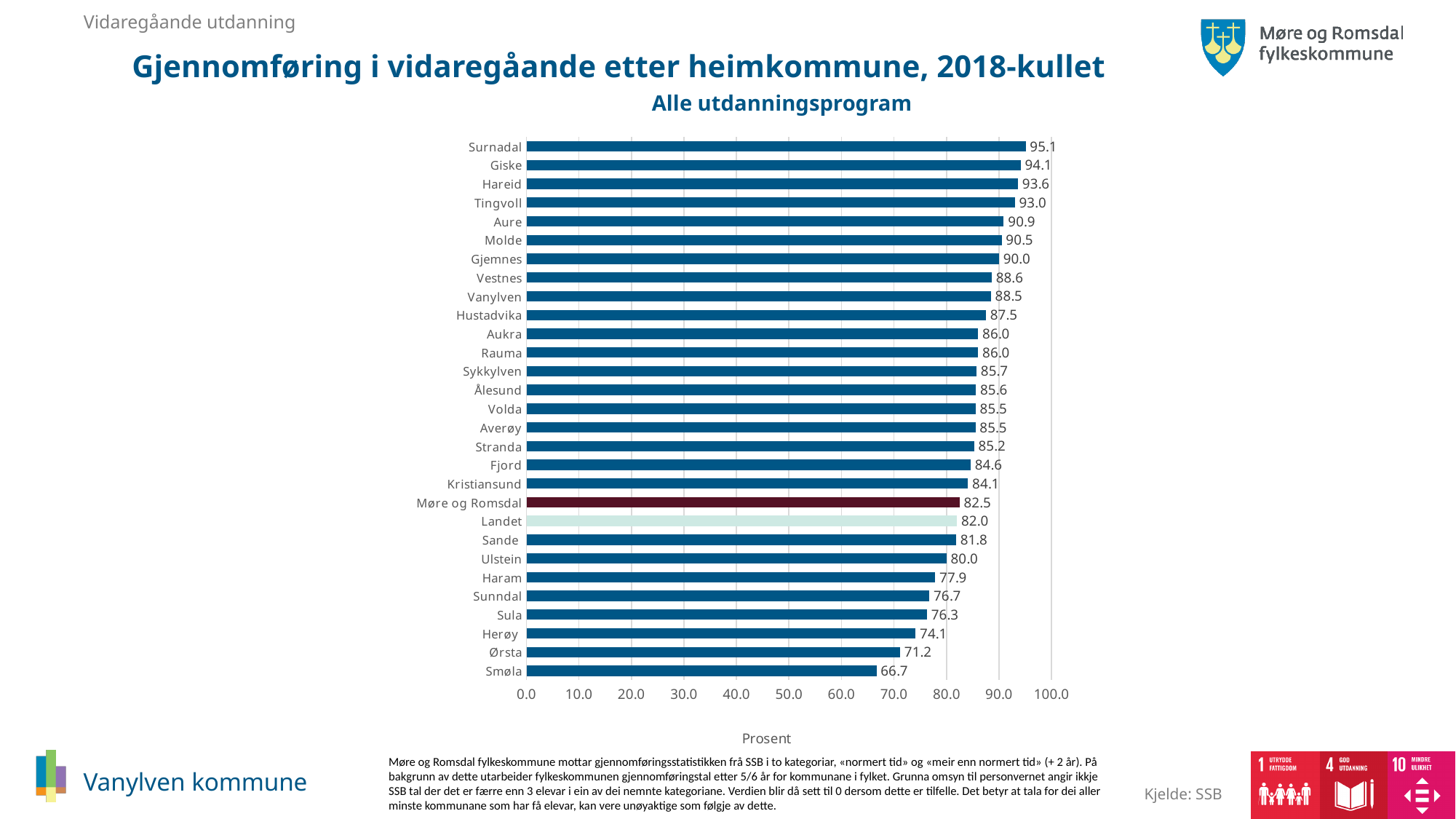
Which category has the lowest value? Smøla Is the value for Ørsta greater or less than 80.0? less What is the value for Vanylven? 88.5 What kind of chart is shown on the slide? bar chart What is the difference between the values for Vanylven and Landet? 6.5 What is the label of the x axis? Prosent What is the difference between the values for Surnadal and Smøla? 28.4 What is the value for Landet? 82.0 What is the value for Møre og Romsdal? 82.5 Which is larger, the value for Molde or the value for Ålesund? Molde How many categories are shown on the chart? 29 Which category has the highest value? Surnadal